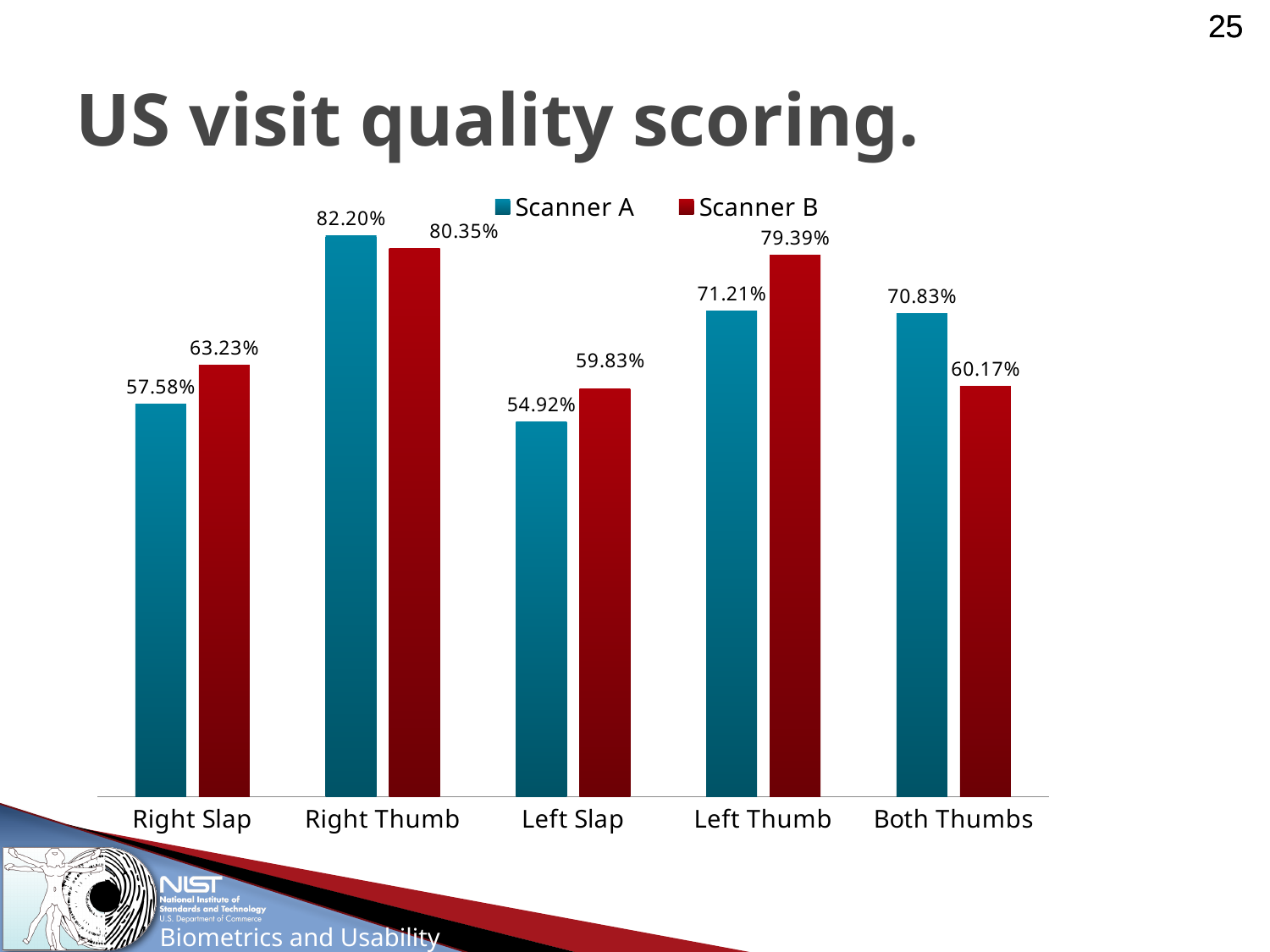
How many categories are shown on the x axis? 5 What is the value for Scanner A for Right Slap? 57.58% For Left Thumb, which scanner has the larger value? Scanner B Which category has the lowest value for Scanner B? Left Slap What kind of chart is shown on the slide? Bar chart What is the value for Scanner B for Both Thumbs? 60.17% Which category has the highest value for Scanner A? Right Thumb What is the value for Scanner B for Left Thumb? 79.39% What is the difference between Scanner B and Scanner A for Right Slap? 5.65% What colour are the Scanner B bars? Red What is the difference between Scanner A and Scanner B for Both Thumbs? 10.66% How many series does the legend list? 2